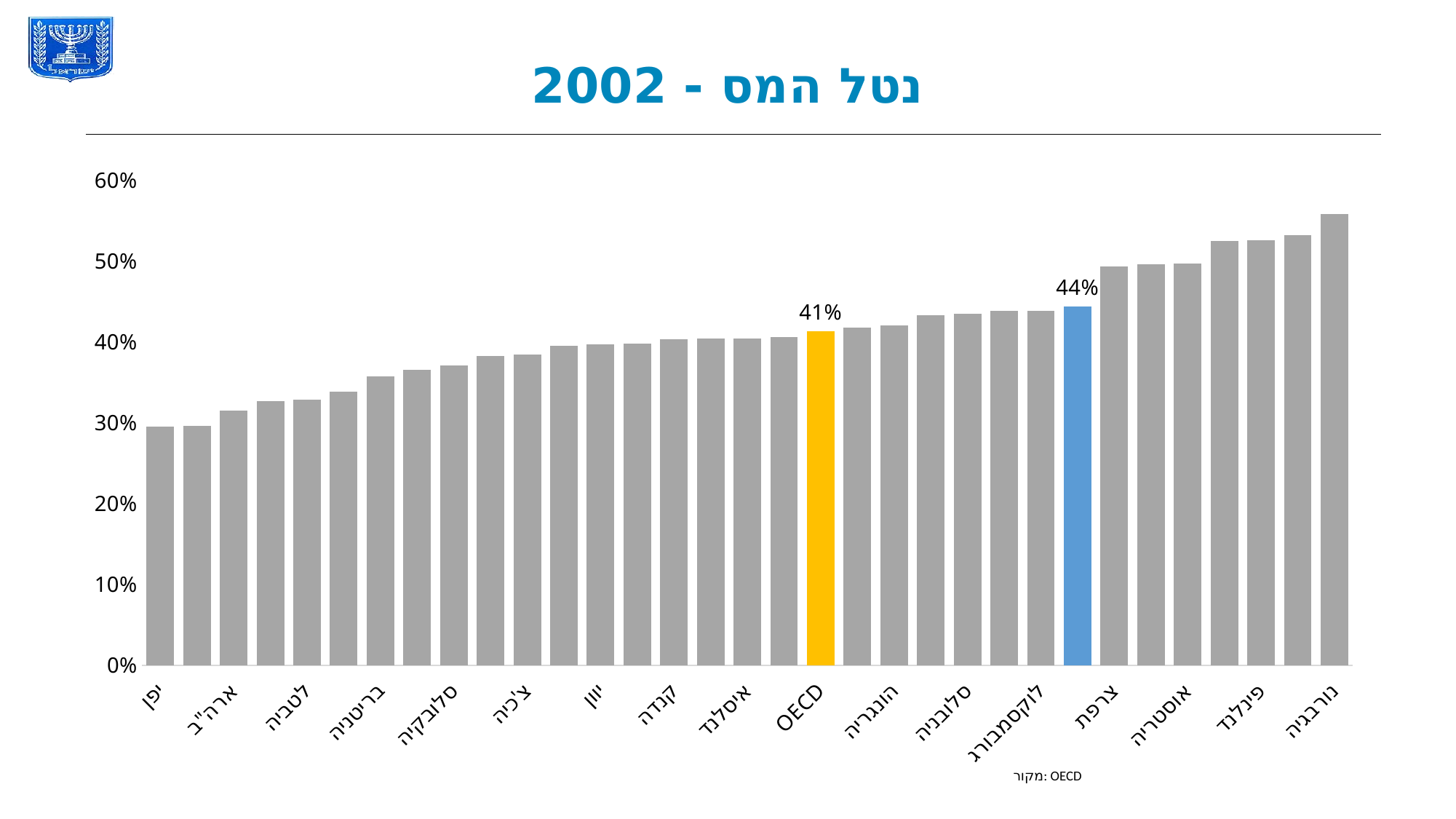
What value is labeled on the blue highlighted bar? 44% Is the value for נורבגיה greater or less than 50%? greater Which labeled country has the highest bar? נורבגיה Is the value for ארה"ב greater or less than 40%? less Which is larger, the value on the blue highlighted bar or the OECD bar? the blue highlighted bar What is the difference between the value on the blue highlighted bar and the OECD bar? 3% Do the bar values rise or fall from left to right along the x axis? rise What is the title of the chart? נטל המס - 2002 Is the value for בריטניה greater or less than 40%? less What value is labeled on the OECD bar? 41% What kind of chart is shown on the slide? bar chart